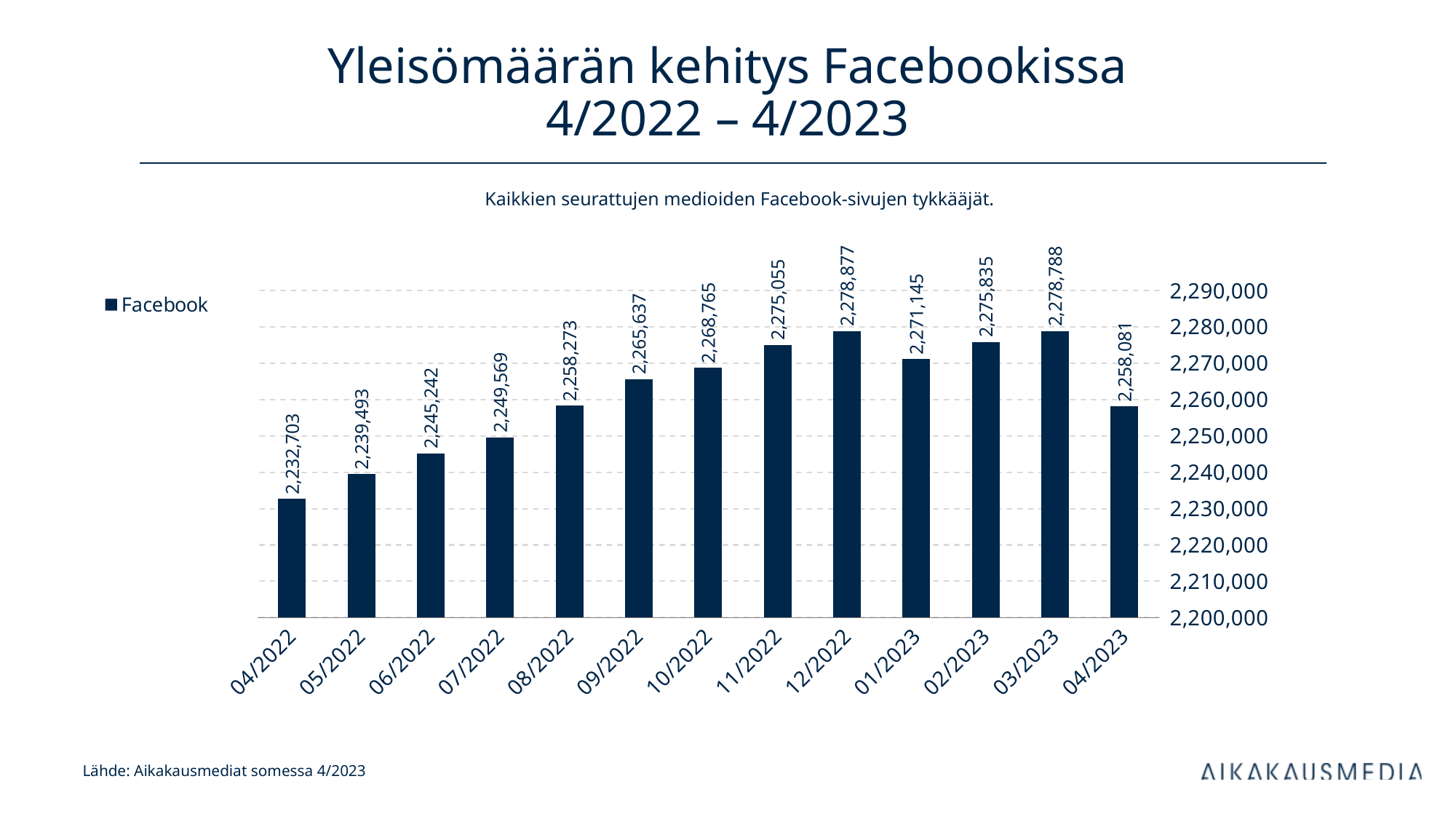
What is the difference between the values for 04/2023 and 04/2022? 25,378 What is the difference between the values for 12/2022 and 01/2023? 7,732 Which month has the lowest value? 04/2022 Which is larger, the value for 09/2022 or the value for 01/2023? 01/2023 What is the value for 04/2022? 2,232,703 Which month has the highest value? 12/2022 How many series does the legend list? 1 What kind of chart is shown on the slide? bar chart How many months are shown on the x axis? 13 What is the value for 04/2023? 2,258,081 Is the value for 08/2022 greater or less than 2,250,000? greater What is the value for 12/2022? 2,278,877